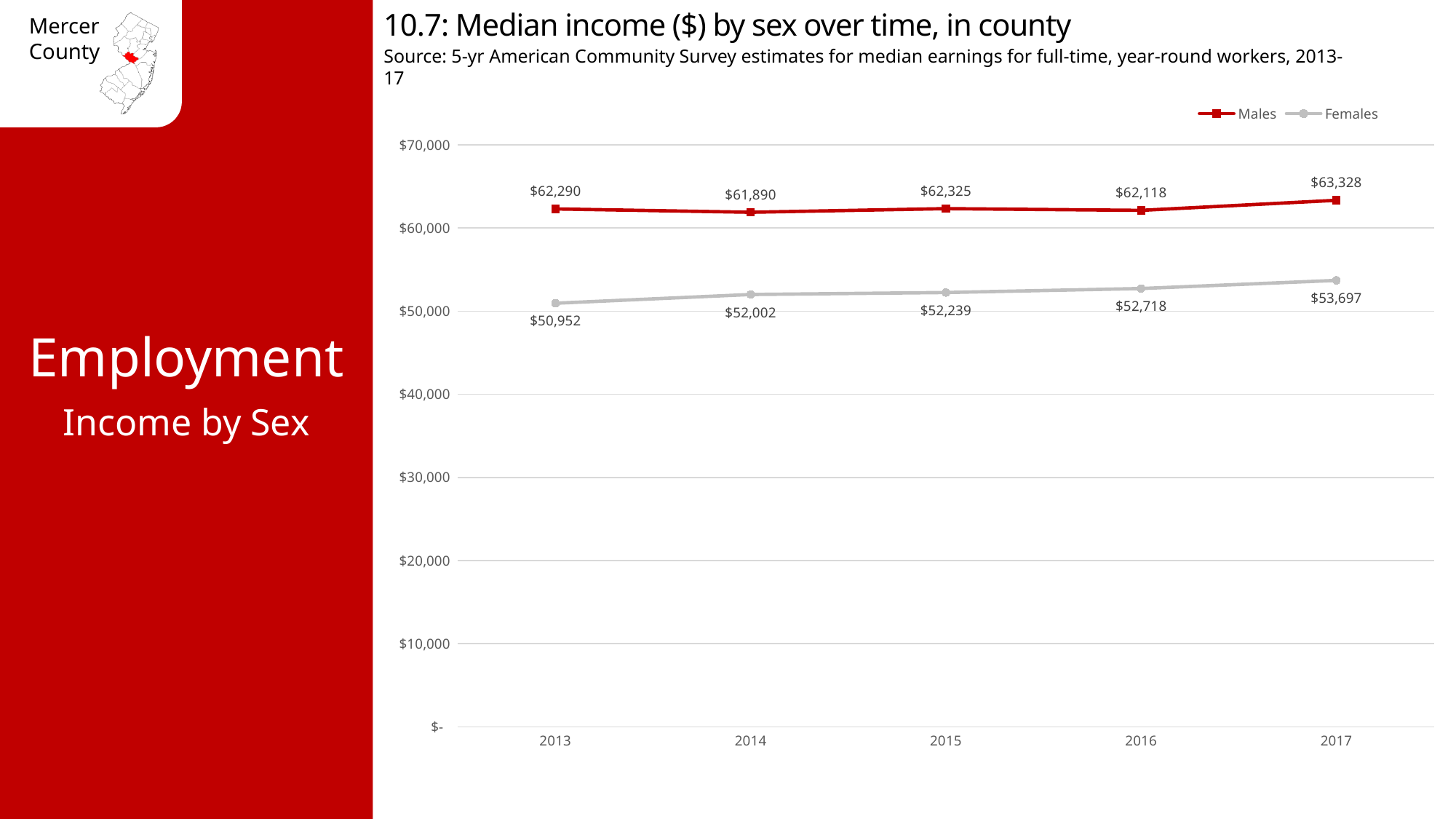
What is the median income for Females in 2013? $50,952 Which is larger in 2014: the Males median income or the Females median income? Males What is the median income for Males in 2017? $63,328 What is the difference between the Males and Females median income in 2017? $9,631 In which year is the Females median income lowest? 2013 Does the Females median income rise or fall from 2013 to 2017? rise What is the median income for Females in 2015? $52,239 How many series does the legend list? 2 Is the Females median income in 2016 greater or less than $50,000? greater In which year is the Males median income highest? 2017 How many years are shown on the x axis? 5 What kind of chart is shown on the slide? line chart